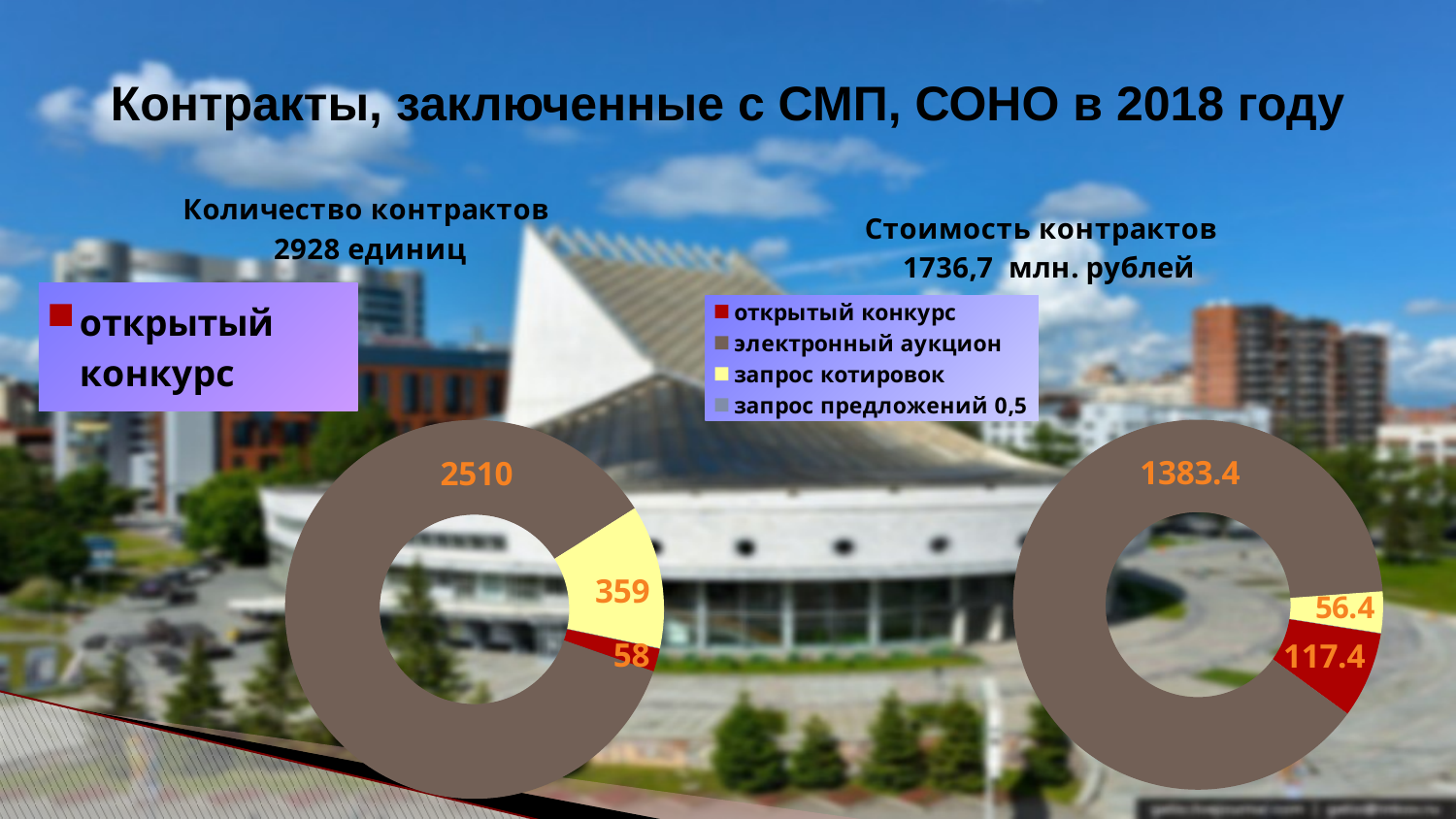
What type of chart is used on the slide for 'Количество контрактов'? Donut (pie) chart In the 'Стоимость контрактов' chart, which category has the smallest value? запрос предложений In the 'Количество контрактов' chart, what is the value of the largest (grey) slice? 2510 How many entries does the legend of the 'Стоимость контрактов' chart list? 4 What total is stated in the heading above the 'Стоимость контрактов' chart? 1736,7 млн. рублей In the 'Стоимость контрактов' chart, what is the value for 'электронный аукцион'? 1383.4 In the 'Количество контрактов' chart, what is the value of the yellow slice? 359 In the 'Стоимость контрактов' chart, what is the value for 'открытый конкурс'? 117.4 In the 'Количество контрактов' chart, what is the value of the red 'открытый конкурс' slice? 58 In the 'Стоимость контрактов' chart, what is the value for 'запрос котировок'? 56.4 In the 'Стоимость контрактов' chart, which is larger: 'открытый конкурс' or 'запрос котировок'? открытый конкурс In the 'Количество контрактов' chart, what is the difference between the yellow slice (359) and the red slice (58)? 301